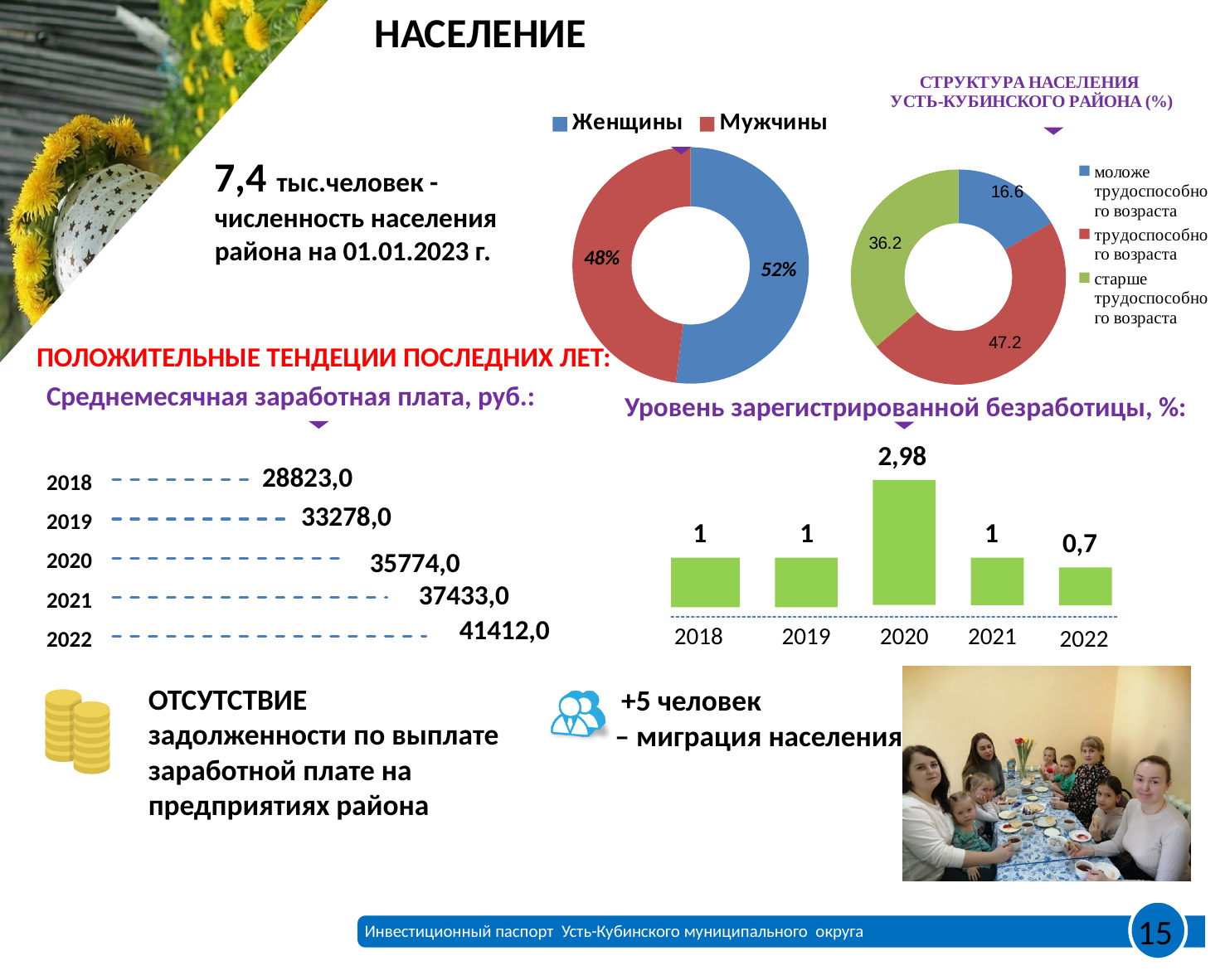
In the chart 'СТРУКТУРА НАСЕЛЕНИЯ УСТЬ-КУБИНСКОГО РАЙОНА (%)', how many categories does the legend list? 3 In the gender donut chart (Женщины/Мужчины), which group has the larger share? Женщины In the chart 'СТРУКТУРА НАСЕЛЕНИЯ УСТЬ-КУБИНСКОГО РАЙОНА (%)', what value is shown for 'трудоспособного возраста'? 47.2 In the chart 'СТРУКТУРА НАСЕЛЕНИЯ УСТЬ-КУБИНСКОГО РАЙОНА (%)', which category has the smallest share? моложе трудоспособного возраста In the chart 'Среднемесячная заработная плата, руб.', what is the value for 2022? 41412,0 In the chart 'Уровень зарегистрированной безработицы, %', how many years are shown? 5 In the gender donut chart (Женщины/Мужчины), what share is shown for Женщины? 52% In the chart 'Уровень зарегистрированной безработицы, %', which year has the lowest value? 2022 What kind of chart is 'Уровень зарегистрированной безработицы, %'? bar chart In the chart 'СТРУКТУРА НАСЕЛЕНИЯ УСТЬ-КУБИНСКОГО РАЙОНА (%)', what is the difference between the values for 'трудоспособного возраста' and 'старше трудоспособного возраста'? 11.0 In the chart 'Уровень зарегистрированной безработицы, %', what is the value for 2020? 2,98 In the gender donut chart (Женщины/Мужчины), what share is shown for Мужчины? 48%